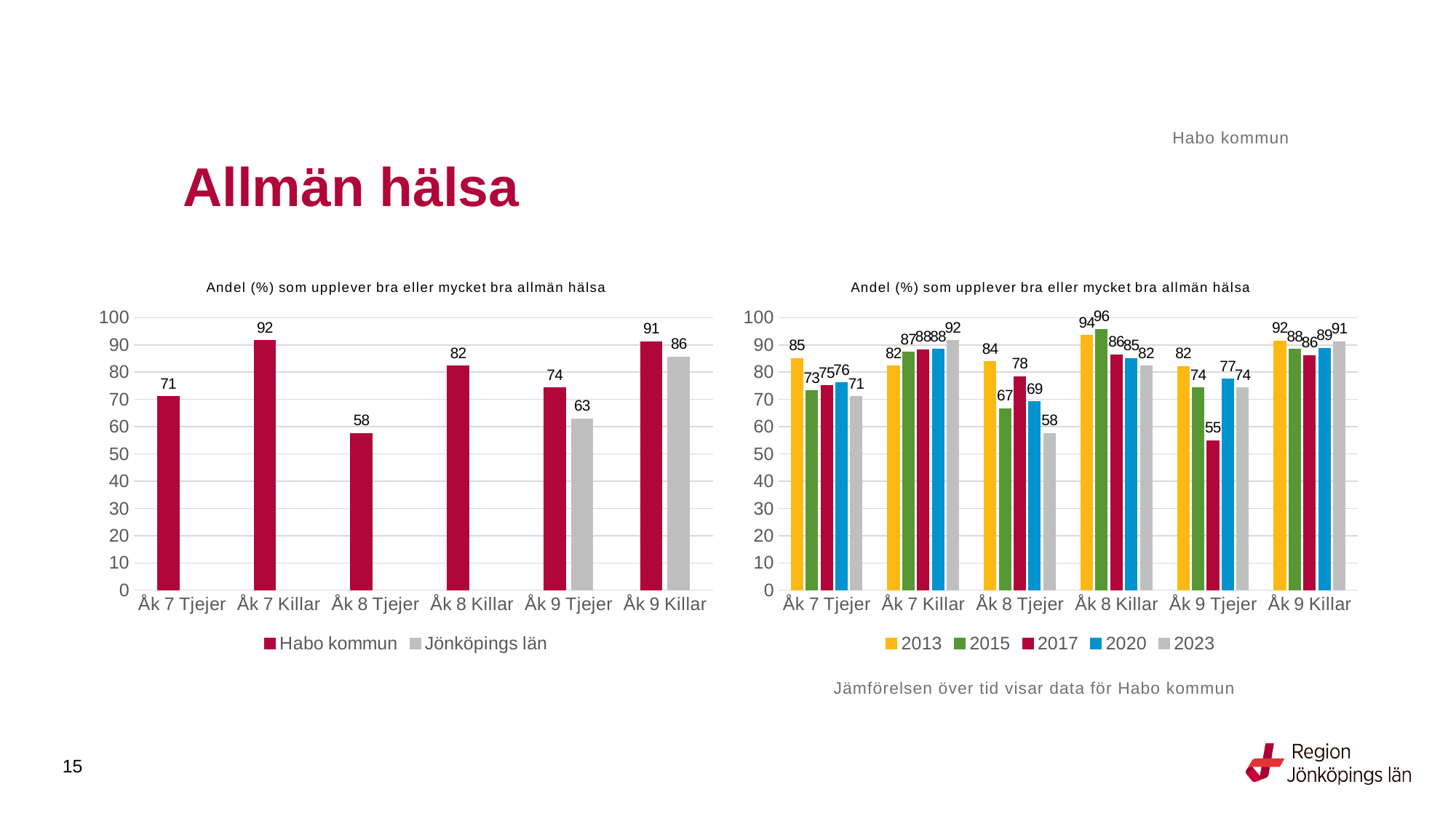
In the right chart, which is larger for Åk 7 Tjejer: the value for 2013 or the value for 2023? 2013 In the left chart, what is the difference between Habo kommun and Jönköpings län for Åk 9 Tjejer? 11 In the left chart, which category has the lowest value for Habo kommun? Åk 8 Tjejer In the right chart, what is the value for 2015 for Åk 8 Killar? 96 In the left chart, what is the value for Jönköpings län for Åk 9 Killar? 86 In the right chart, which year has the highest value for Åk 8 Tjejer? 2013 In the left chart, which category has the highest value for Habo kommun? Åk 7 Killar In the right chart, how many series does the legend list? 5 In the left chart, how many series does the legend list? 2 What kind of chart is the right chart? Bar chart In the left chart, what is the value for Habo kommun for Åk 8 Tjejer? 58 In the right chart, what is the value for 2017 for Åk 9 Tjejer? 55